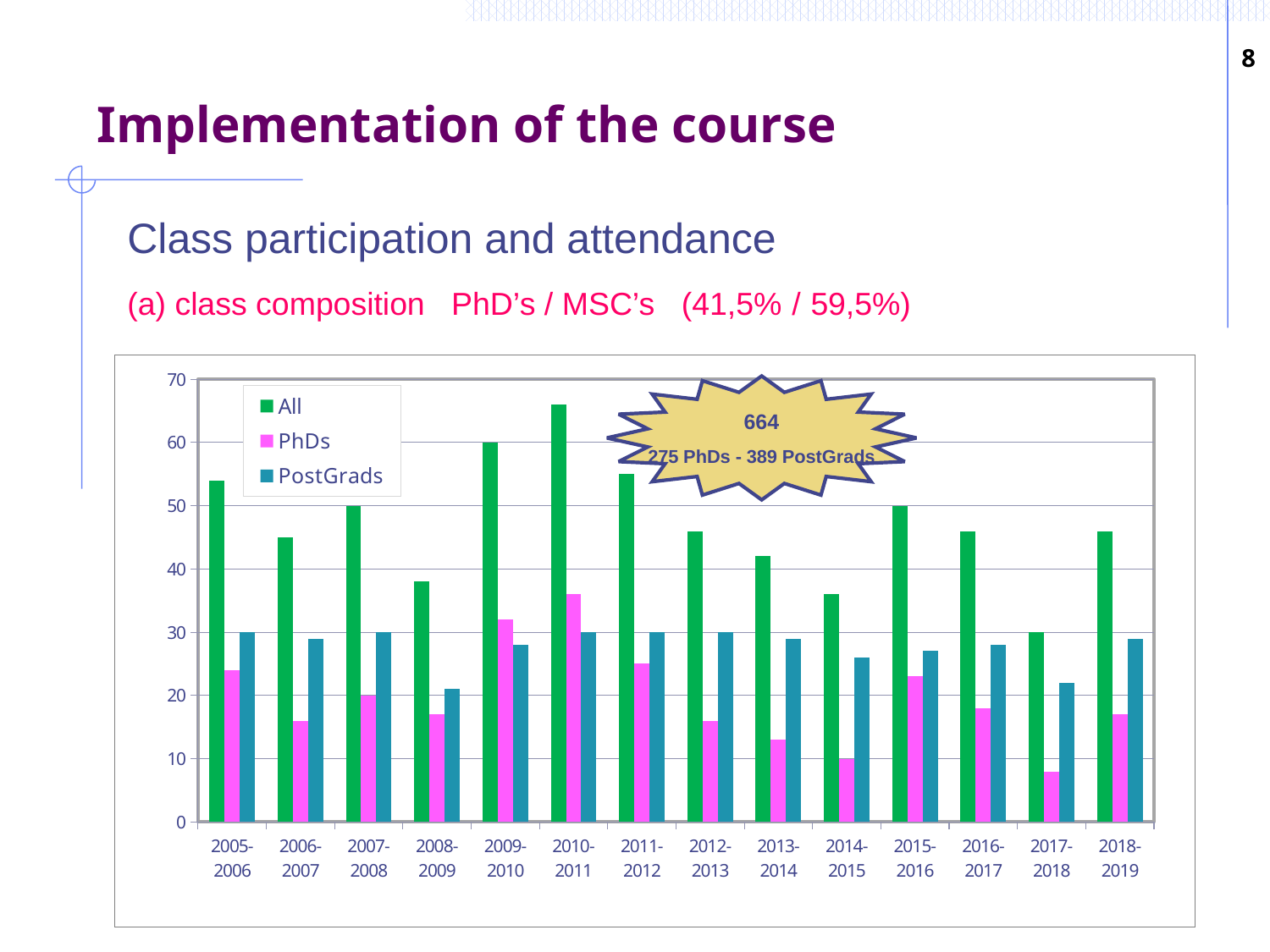
How many series does the legend list? 3 Is the value for All in 2010-2011 greater or less than 60? greater What total number is shown in the starburst callout on the chart? 664 What kind of chart is shown on the slide? bar chart How many academic-year categories are shown on the x axis? 14 In which academic year is the value for PhDs the highest? 2010-2011 In which academic year is the value for All the highest? 2010-2011 Which is larger, the value for All in 2005-2006 or in 2006-2007? 2005-2006 In which academic year is the value for PhDs the lowest? 2017-2018 In which academic year is the value for All the lowest? 2017-2018 Is the value for All in 2008-2009 greater or less than 40? less Is the value for PhDs in 2009-2010 greater or less than 30? greater